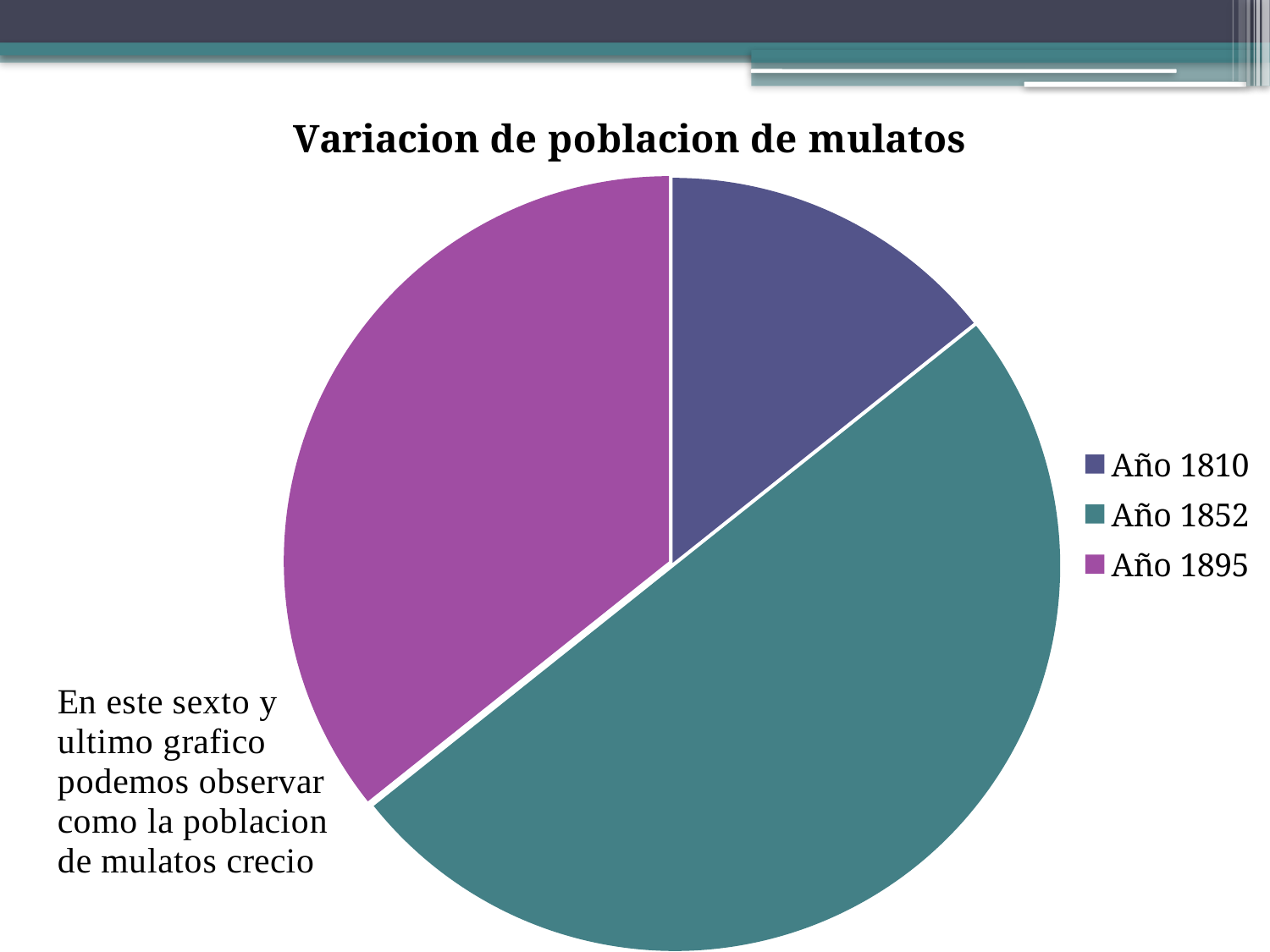
What colour is the slice for Año 1895? purple What is the title of the chart? Variacion de poblacion de mulatos Which category has the largest slice of the pie? Año 1852 Which slice is smaller, Año 1810 or Año 1852? Año 1810 How many entries does the legend list? 3 What kind of chart is shown on the slide? pie chart Which slice is larger, Año 1852 or Año 1895? Año 1852 How many slices does the pie chart have? 3 Which slice is larger, Año 1810 or Año 1895? Año 1895 Which category has the smallest slice of the pie? Año 1810